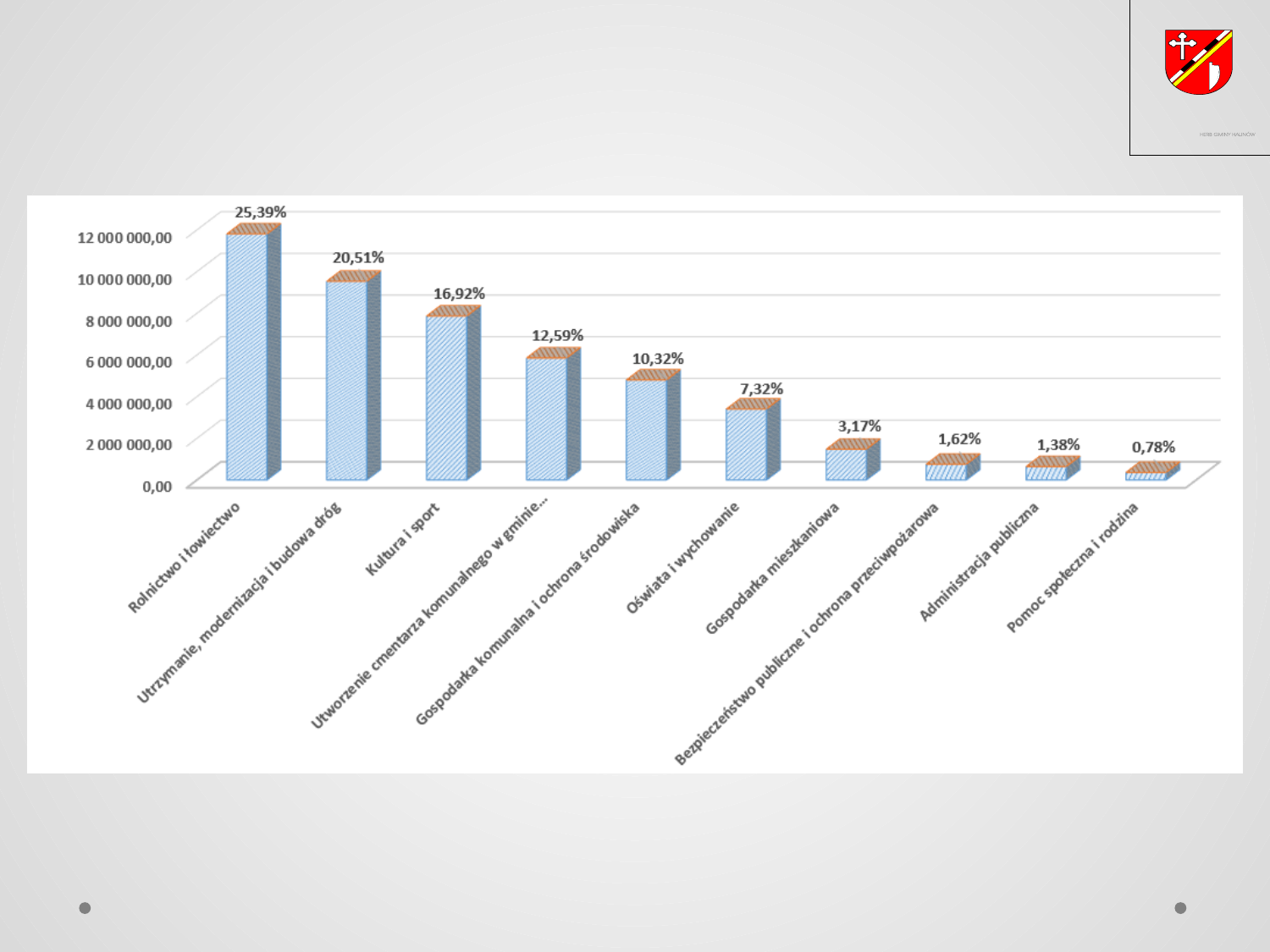
Which is larger, the value for Gospodarka komunalna i ochrona środowiska or the value for Gospodarka mieszkaniowa? Gospodarka komunalna i ochrona środowiska What percentage is shown for Rolnictwo i łowiectwo? 25,39% What is the difference in percentage points between Rolnictwo i łowiectwo and Utrzymanie, modernizacja i budowa dróg? 4,88% Do the values rise or fall from left to right along the x axis? fall How many categories are plotted on the chart? 10 Which category has the lowest value? Pomoc społeczna i rodzina What percentage is shown for Oświata i wychowanie? 7,32% What kind of chart is shown on the slide? bar chart What percentage is shown for Kultura i sport? 16,92% Is the value for Utrzymanie, modernizacja i budowa dróg greater or less than 8 000 000,00? greater What percentage is shown for Administracja publiczna? 1,38% Which category has the highest value? Rolnictwo i łowiectwo